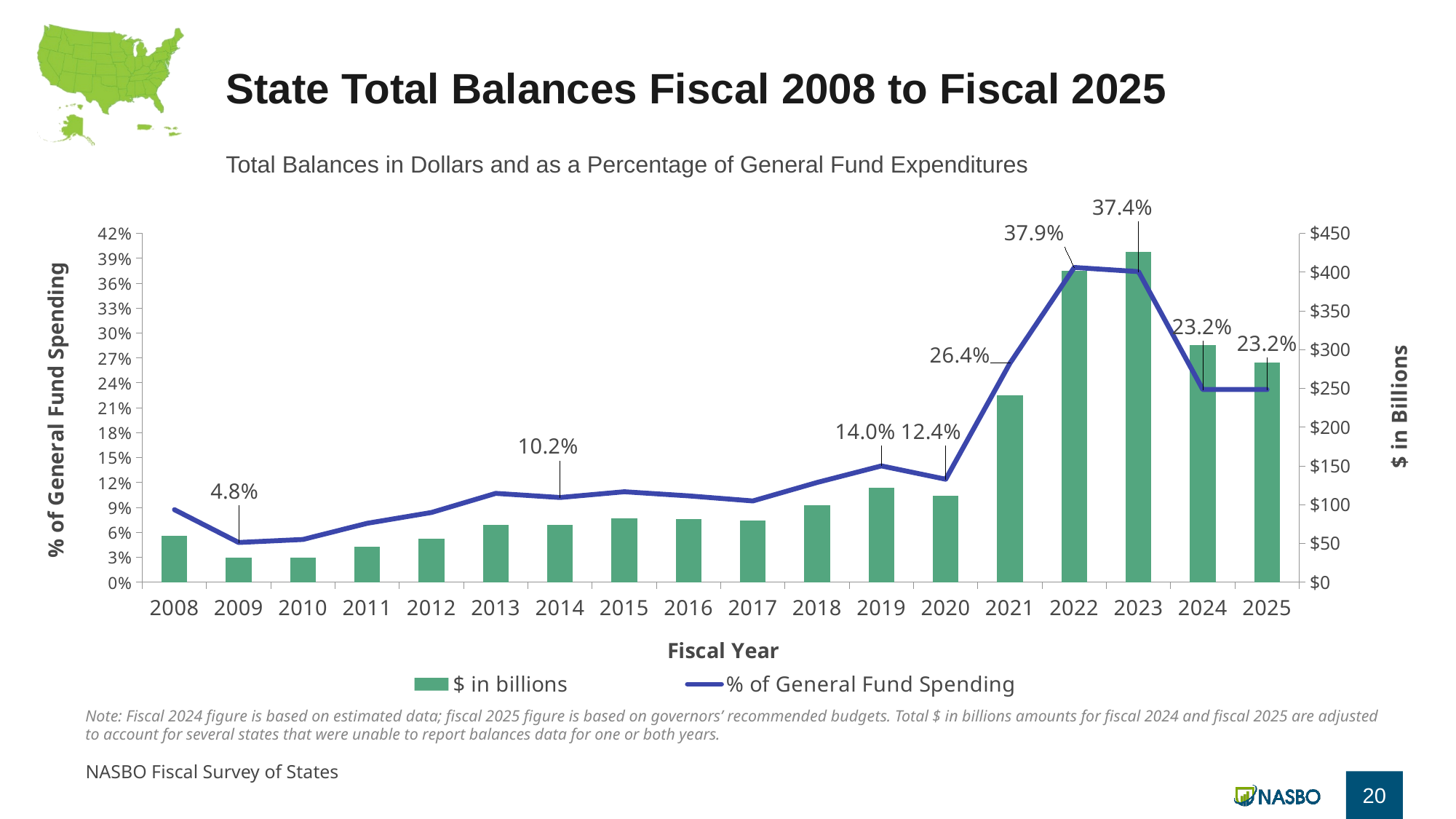
What is the % of General Fund Spending value for fiscal 2025? 23.2% Is the $ in billions value for fiscal 2019 greater or less than $100? greater Which fiscal year has the highest % of General Fund Spending value? 2022 Which fiscal year has the tallest $ in billions bar? 2023 Is the $ in billions value for fiscal 2023 greater or less than $400? greater What is the % of General Fund Spending value for fiscal 2022? 37.9% What is the % of General Fund Spending value for fiscal 2009? 4.8% What is the % of General Fund Spending value for fiscal 2020? 12.4% How many fiscal years are shown on the x axis? 18 Which is larger, the % of General Fund Spending value for fiscal 2021 or for fiscal 2019? 2021 How many series does the legend list? 2 What is the difference between the % of General Fund Spending values for fiscal 2022 and fiscal 2023? 0.5 percentage points